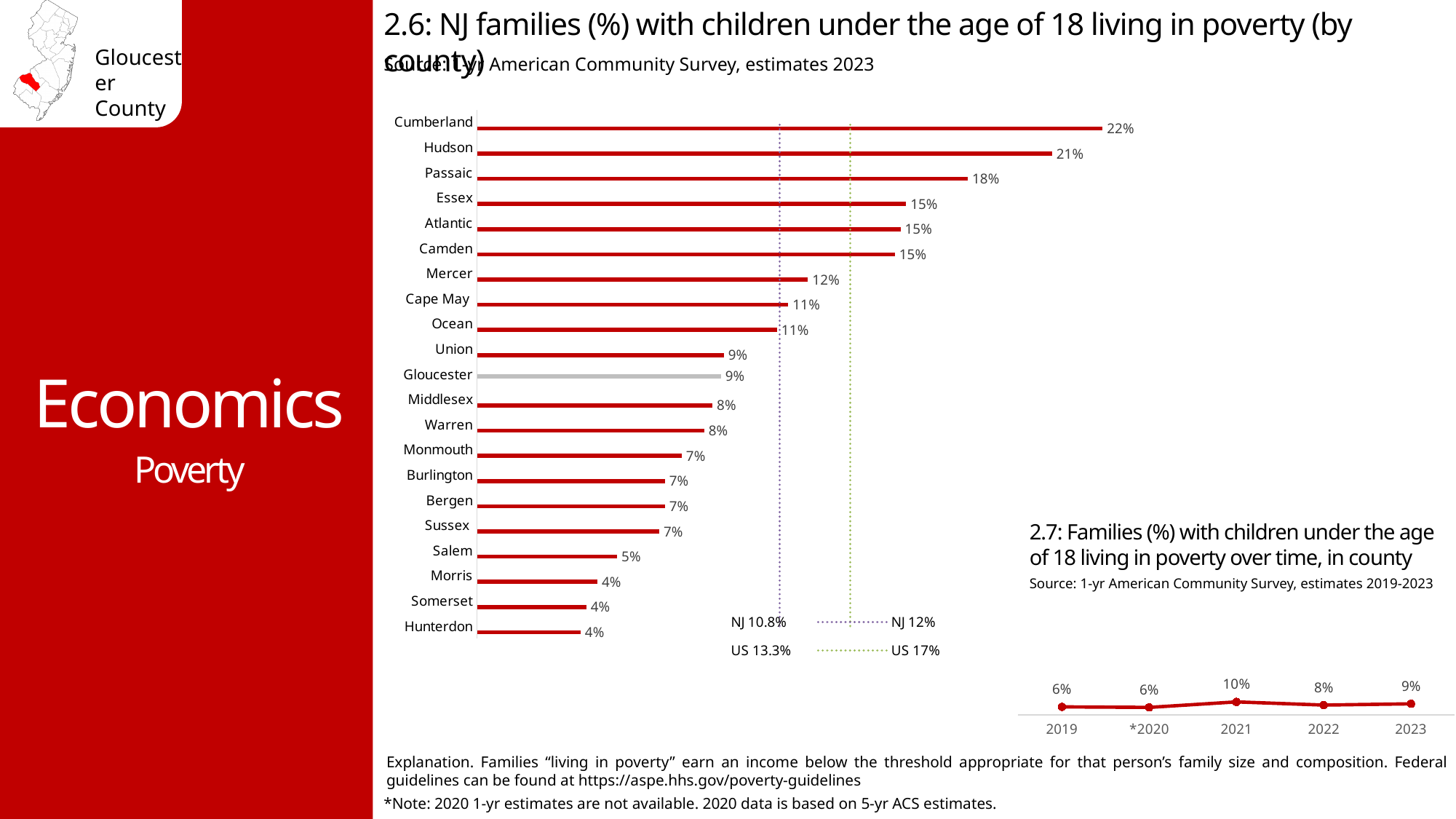
In chart 2.6, what percentage of families with children under 18 live in poverty in Gloucester County? 9% In chart 2.7, which year has the highest value? 2021 In chart 2.6, what is the value shown for Hudson County? 21% In chart 2.7, what is the difference between the values for 2023 and 2019? 3% In chart 2.6, which has a higher value, Passaic or Mercer? Passaic In chart 2.7, how many years are plotted? 5 In chart 2.6, which county has the highest percentage of families with children under 18 living in poverty? Cumberland In chart 2.6, how many counties are plotted? 21 In chart 2.6, what is the difference between the values for Cumberland and Gloucester? 13% What kind of chart is chart 2.6? Bar chart In chart 2.7, what is the value for 2021? 10%